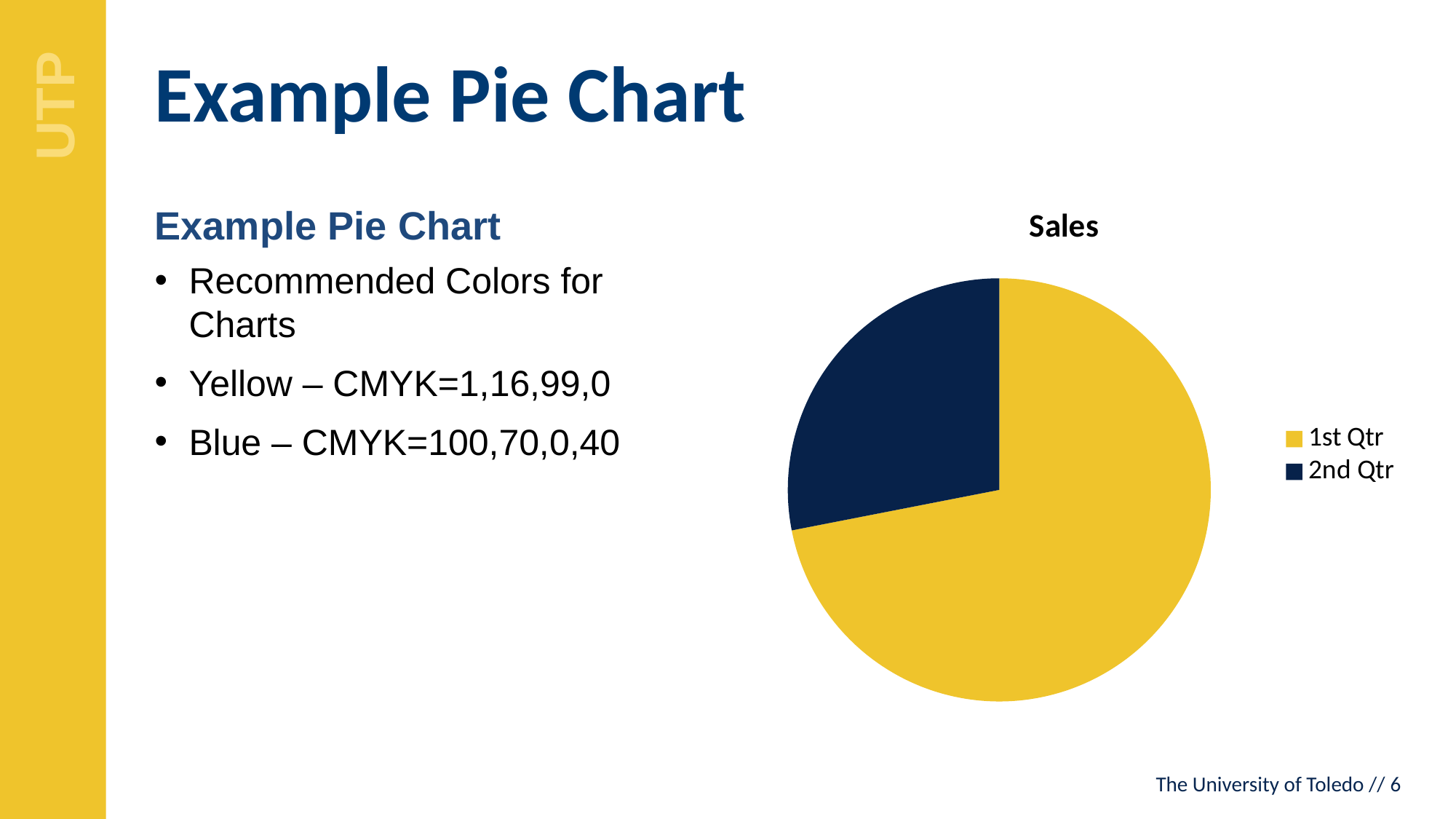
How many slices does the pie chart have? 2 What kind of chart is shown on the slide? pie chart How many entries does the legend list? 2 Which slice is the smallest in the pie chart? 2nd Qtr Which is larger, the 1st Qtr slice or the 2nd Qtr slice? 1st Qtr What colour is the 2nd Qtr slice? dark blue Which slice is the largest in the pie chart? 1st Qtr What is the title of the chart? Sales